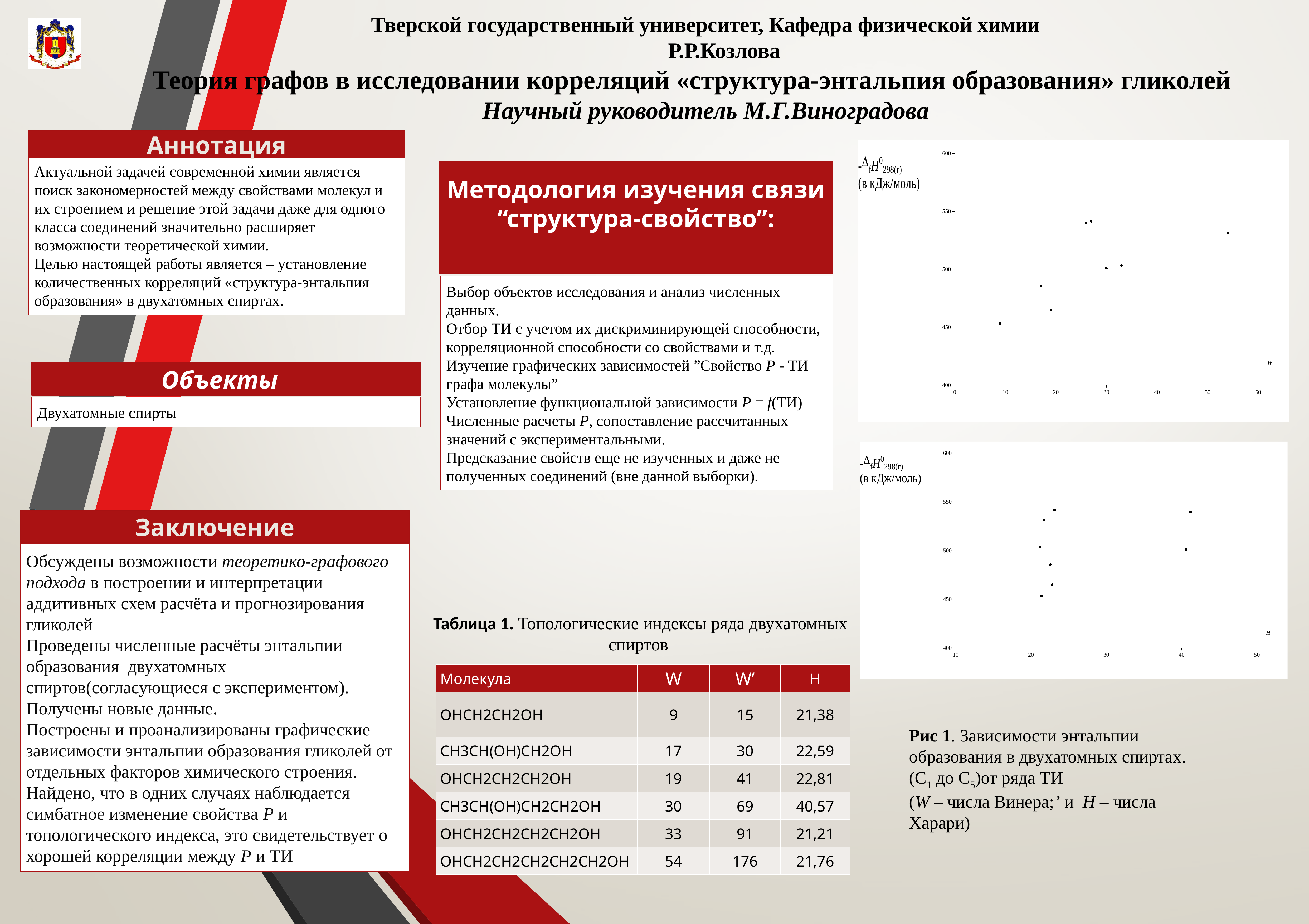
In the bottom chart (x axis H), what is the label of the x axis? H In the top chart (x axis W), how many data points are plotted? 8 In the bottom chart (x axis H), is the value of the lowest point greater or less than 500? less In the bottom chart (x axis H), is the value of the highest point greater or less than 500? greater What kind of chart is the bottom chart on the right of the slide? scatter chart What kind of chart is the top chart on the right of the slide? scatter chart In the top chart (x axis W), what is the label of the x axis? W In the top chart (x axis W), is the value of the point near W = 54 greater or less than 500? greater In the top chart (x axis W), what is the highest tick value shown on the x axis? 60 How many charts are shown on the slide? 2